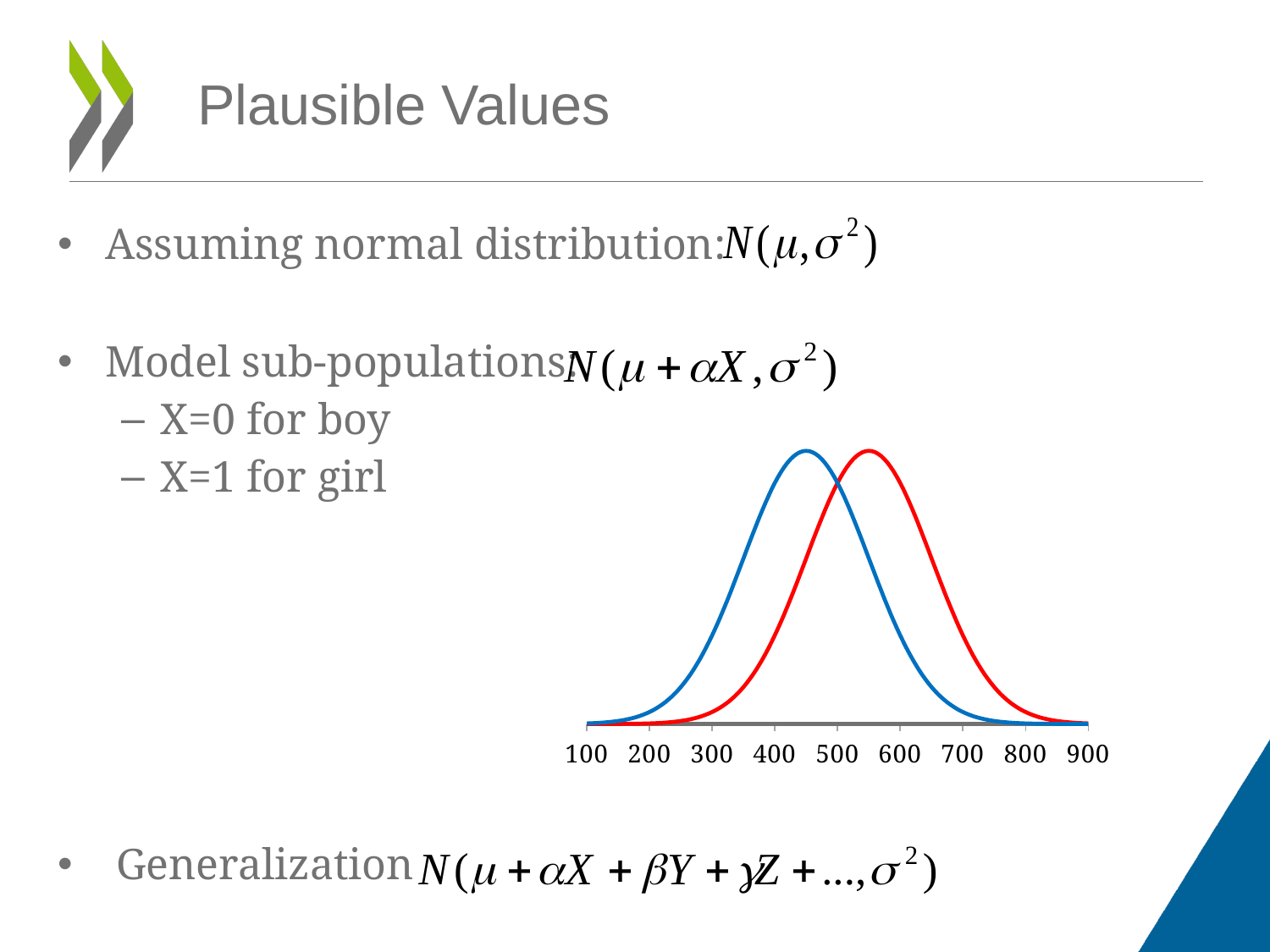
How many curves are plotted on the chart? 2 Is the x-axis position of the blue curve's peak greater or less than 300? greater Is the x-axis position of the red curve's peak greater or less than 700? less Is the x-axis position of the red curve's peak greater or less than 500? greater What kind of chart is shown on the slide? line chart Which curve peaks further to the right on the x axis, the blue one or the red one? red What colours are the two curves on the chart? blue and red What are the lowest and highest tick values shown on the x axis? 100 and 900